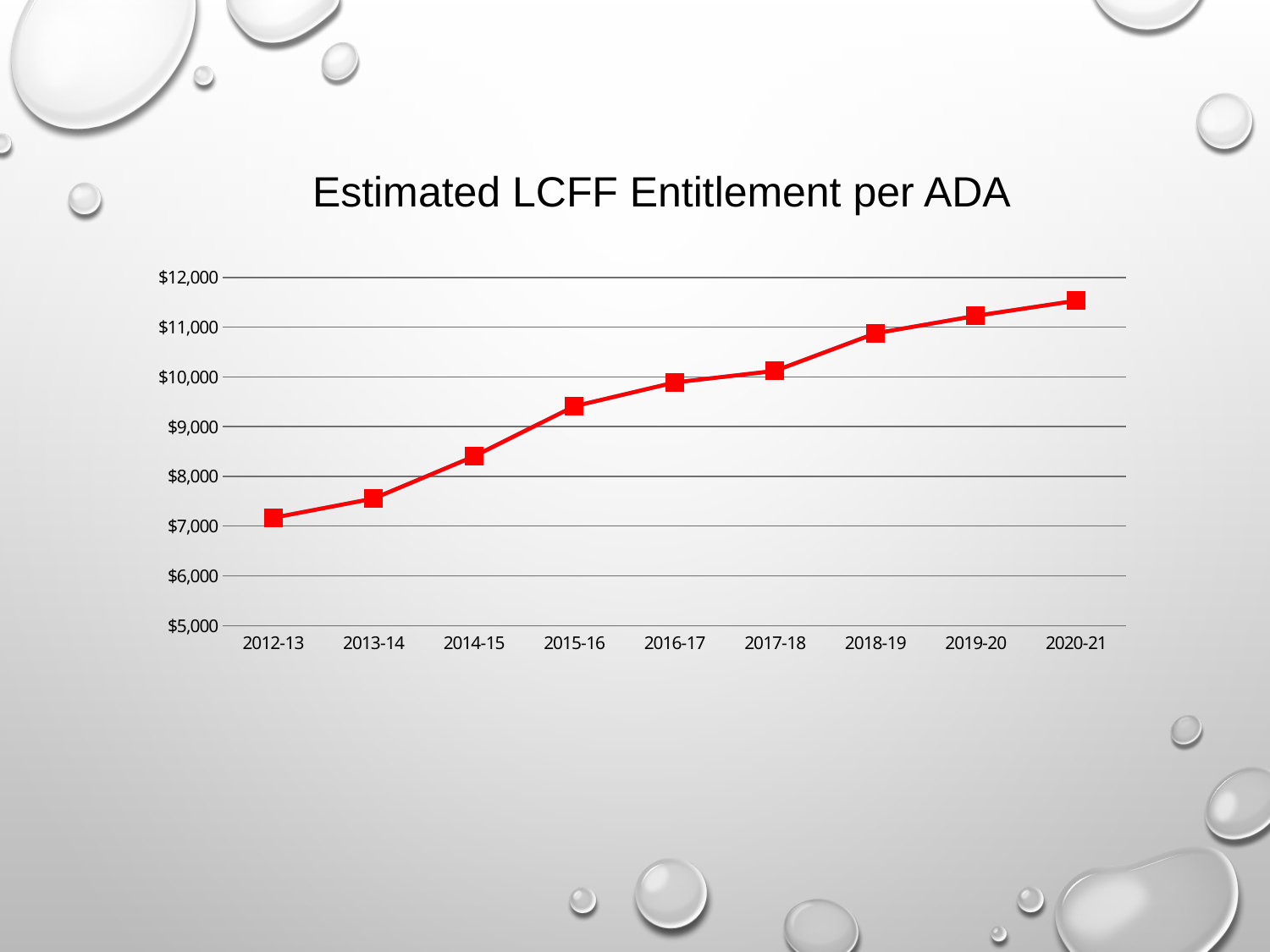
What kind of chart is shown on the slide? line chart Do the values rise or fall from 2012-13 to 2020-21? rise Is the value for 2020-21 greater or less than $12,000? less What is the title of the chart? Estimated LCFF Entitlement per ADA Is the value for 2013-14 greater or less than $8,000? less Is the value for 2012-13 greater or less than $7,000? greater How many fiscal years are plotted on the x axis? 9 Which year has the lowest estimated LCFF entitlement per ADA? 2012-13 Which year has the highest estimated LCFF entitlement per ADA? 2020-21 Which is larger, the value for 2014-15 or the value for 2018-19? 2018-19